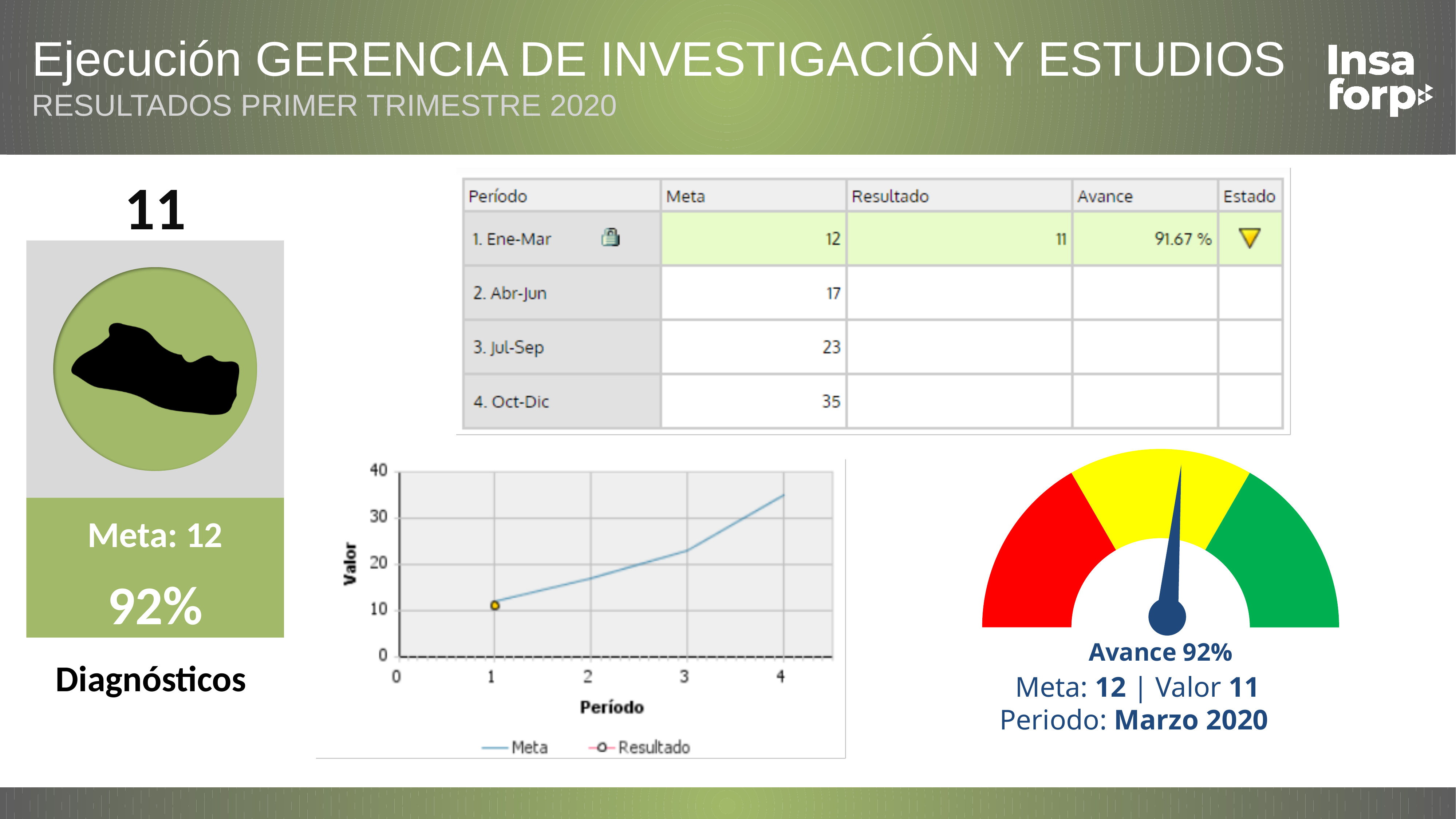
What kind of chart is the chart with the Meta and Resultado legend? line chart In the line chart, is the Resultado point at Período 1 greater or less than 20? less What is the difference between the Meta and the Resultado for period 1 (Ene-Mar)? 1 How many series does the legend of the line chart list? 2 Which Período has the highest Meta value in the line chart? 4 What Avance percentage does the gauge chart on the right show? 92% What is the Meta value for period 4 (Oct-Dic) shown in the table? 35 What are the two series named in the legend of the line chart? Meta and Resultado What is the Resultado value for period 1 (Ene-Mar) shown in the table? 11 In the line chart, is the Meta value at Período 2 greater or less than 20? less In the line chart, does the Meta line rise or fall as the Período increases from 1 to 4? rises In the line chart, is the Meta value at Período 4 greater or less than 30? greater